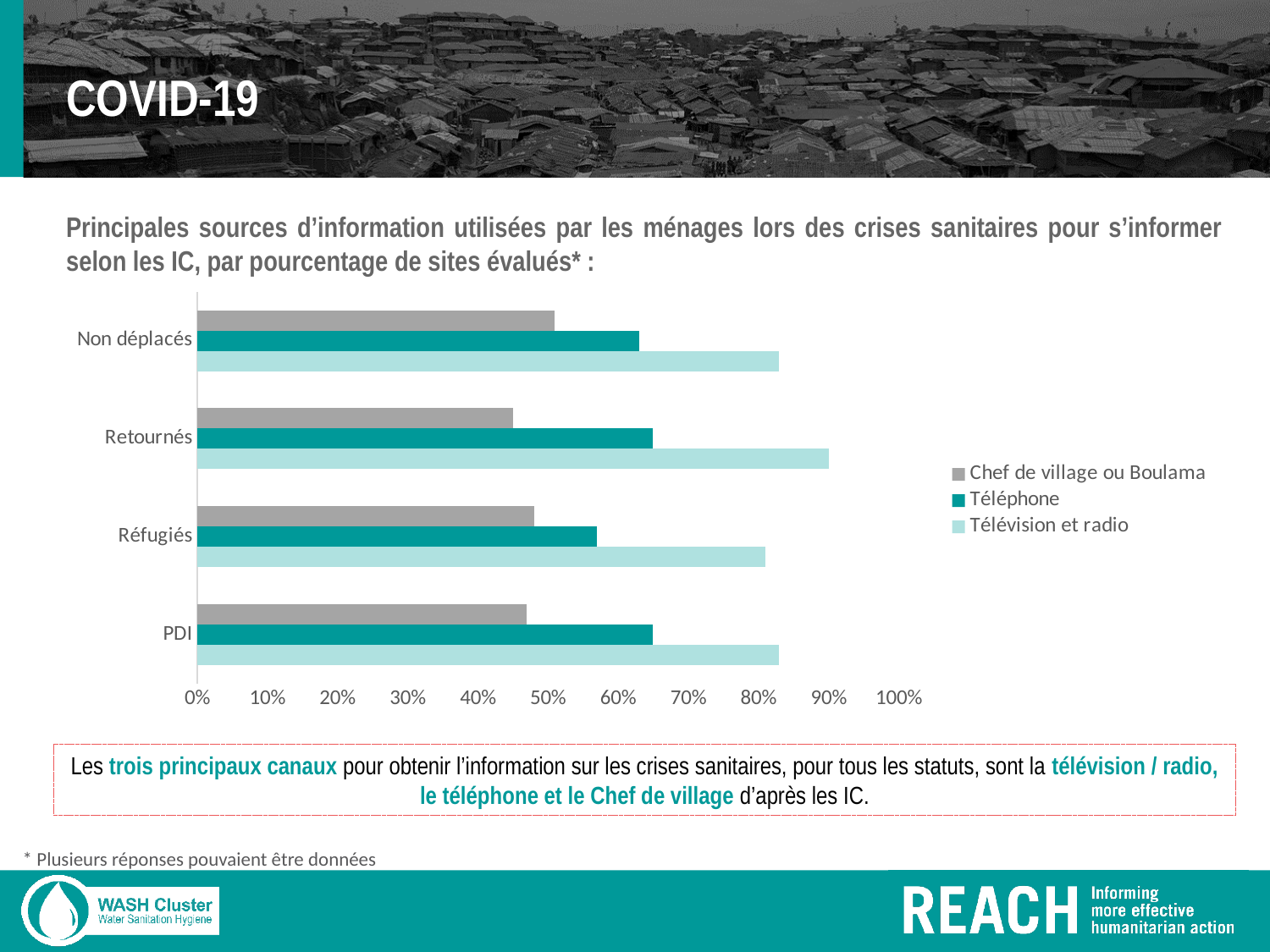
What kind of chart is shown on the slide? bar chart Is the value for Télévision et radio among Retournés greater or less than 80%? greater What are the three series listed in the chart legend? Chef de village ou Boulama, Téléphone, Télévision et radio Is the value for Chef de village ou Boulama among Non déplacés greater or less than 60%? less Which category has the highest value for Télévision et radio? Retournés Which category has the lowest value for Téléphone? Réfugiés How many population categories are shown on the y axis of the chart? 4 Which is larger: the Télévision et radio value for Non déplacés or for Retournés? Retournés Is the value for Téléphone among PDI greater or less than 50%? greater How many series does the chart legend list? 3 For Réfugiés, which is larger: Téléphone or Chef de village ou Boulama? Téléphone For PDI, which series has the highest value? Télévision et radio